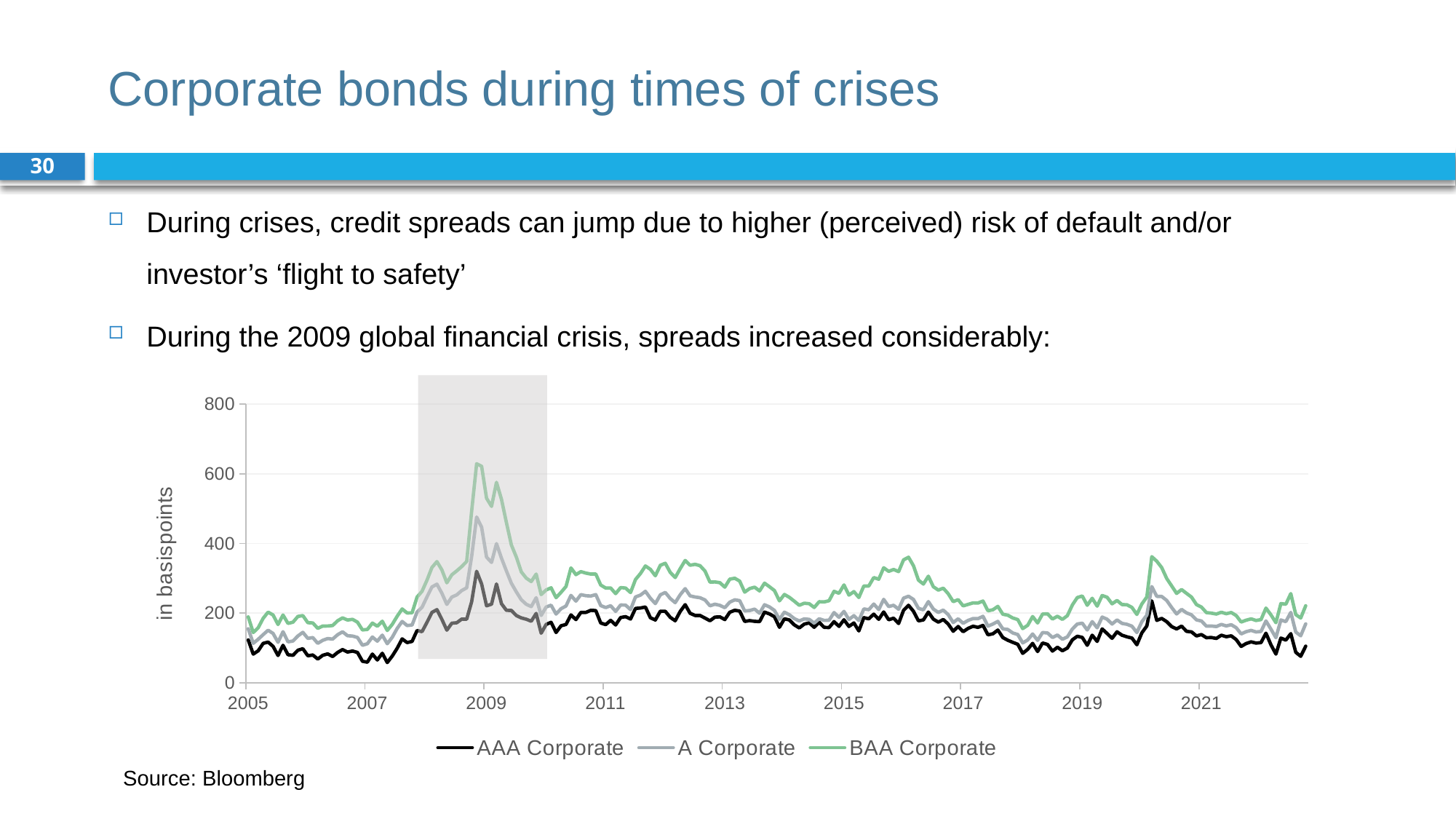
Is the peak value of AAA Corporate around 2009 greater or less than 400? less What colour is the BAA Corporate line? green At the 2009 peak, which is larger: BAA Corporate or AAA Corporate? BAA Corporate Which series has the lowest values throughout the chart? AAA Corporate How many series does the legend list? 3 Is the peak value of BAA Corporate around 2009 greater or less than 400? greater What is the label of the y axis? in basispoints What kind of chart is shown on the slide? line chart Which series reaches the highest value on the chart? BAA Corporate Do the BAA Corporate spreads rise or fall from their 2009 peak to 2011? fall How many year labels are shown on the x axis? 9 Is the value of AAA Corporate at the start of 2005 greater or less than 200? less